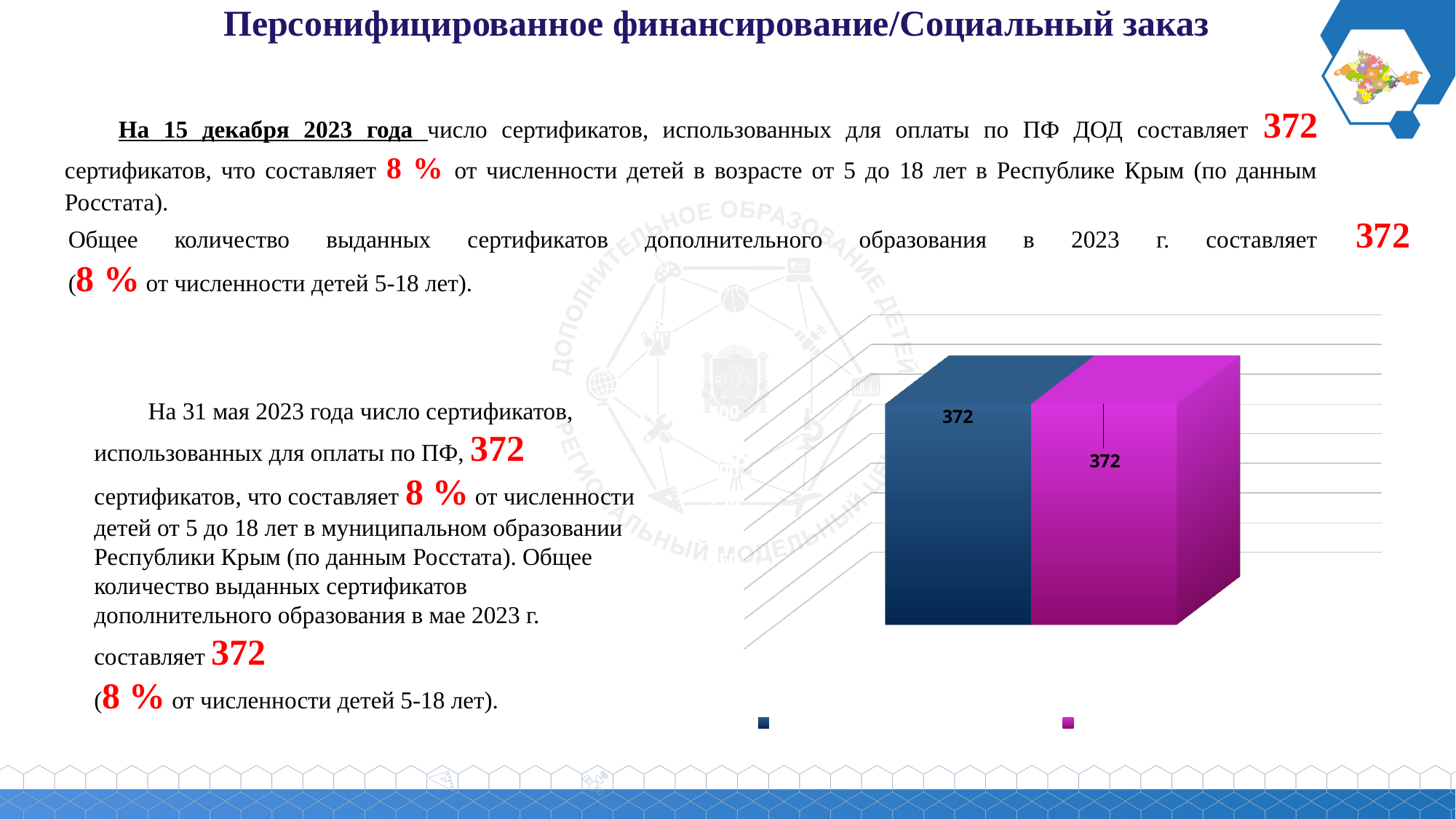
What colour is the right bar in the chart? magenta What value is printed on the left, dark blue bar? 372 What kind of chart is shown on the slide? bar chart What colour is the left bar in the chart? dark blue Do the values change from the left bar to the right bar? No, they stay the same What is the difference between the values of the two bars? 0 How many bars are plotted in the chart? 2 What value is printed on the right, magenta bar? 372 Which bar is larger, the dark blue one or the magenta one? They are equal How many series does the legend below the chart list? 2